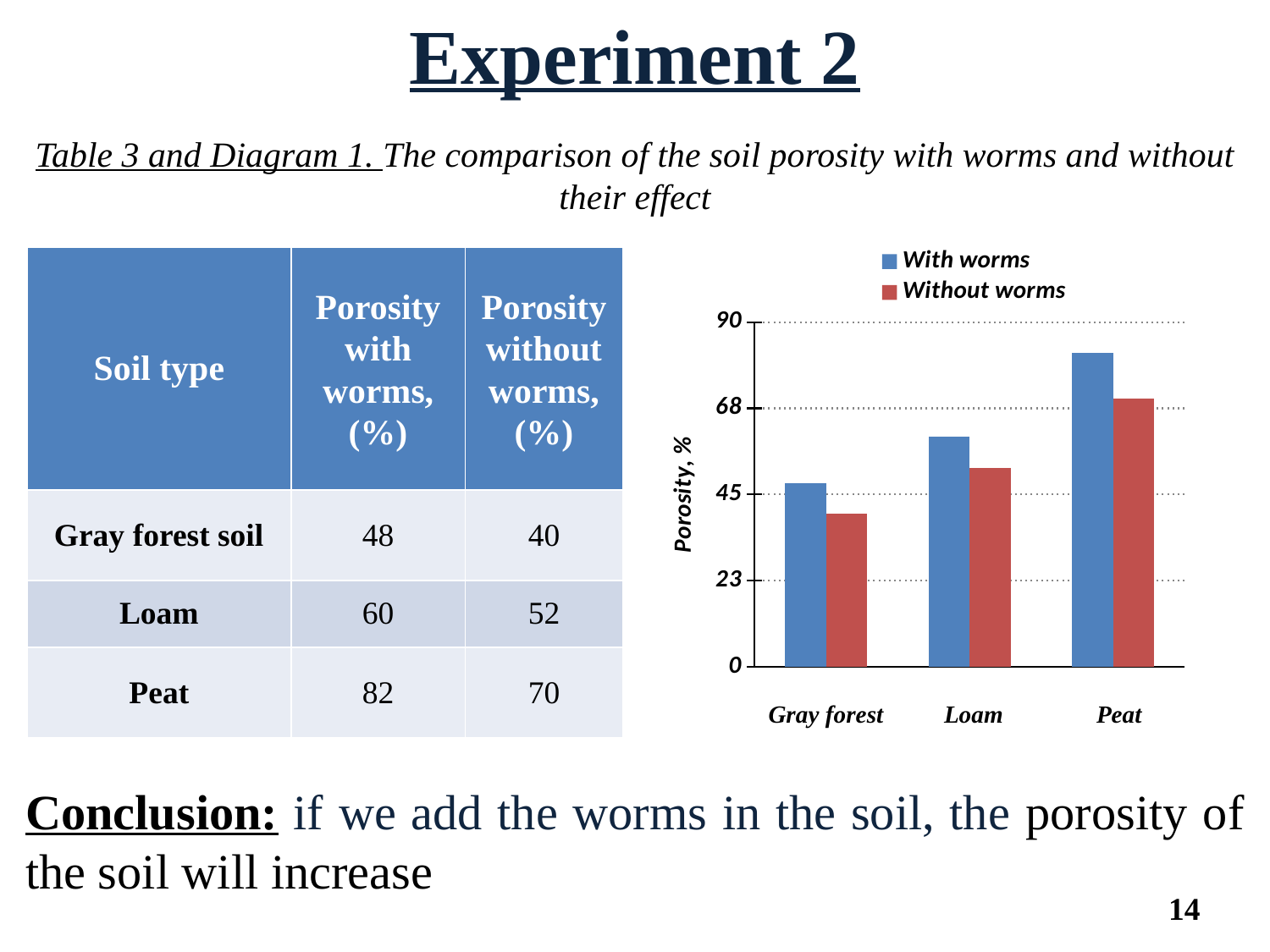
According to the slide, what is the difference between porosity with worms and without worms for Gray forest soil? 8 Which soil type has the highest porosity with worms? Peat Is the porosity with worms for Loam greater or less than 68? less According to the slide, what is the porosity with worms for Peat? 82 For Loam, which is larger: porosity with worms or porosity without worms? with worms Is the porosity without worms for Gray forest greater or less than 45? less Is the porosity with worms for Peat greater or less than 68? greater How many soil types are shown on the x axis of the chart? 3 What is the label of the vertical axis of the chart? Porosity, % How many series does the chart legend list? 2 What type of chart is shown on the slide? bar chart Which soil type has the lowest porosity without worms? Gray forest